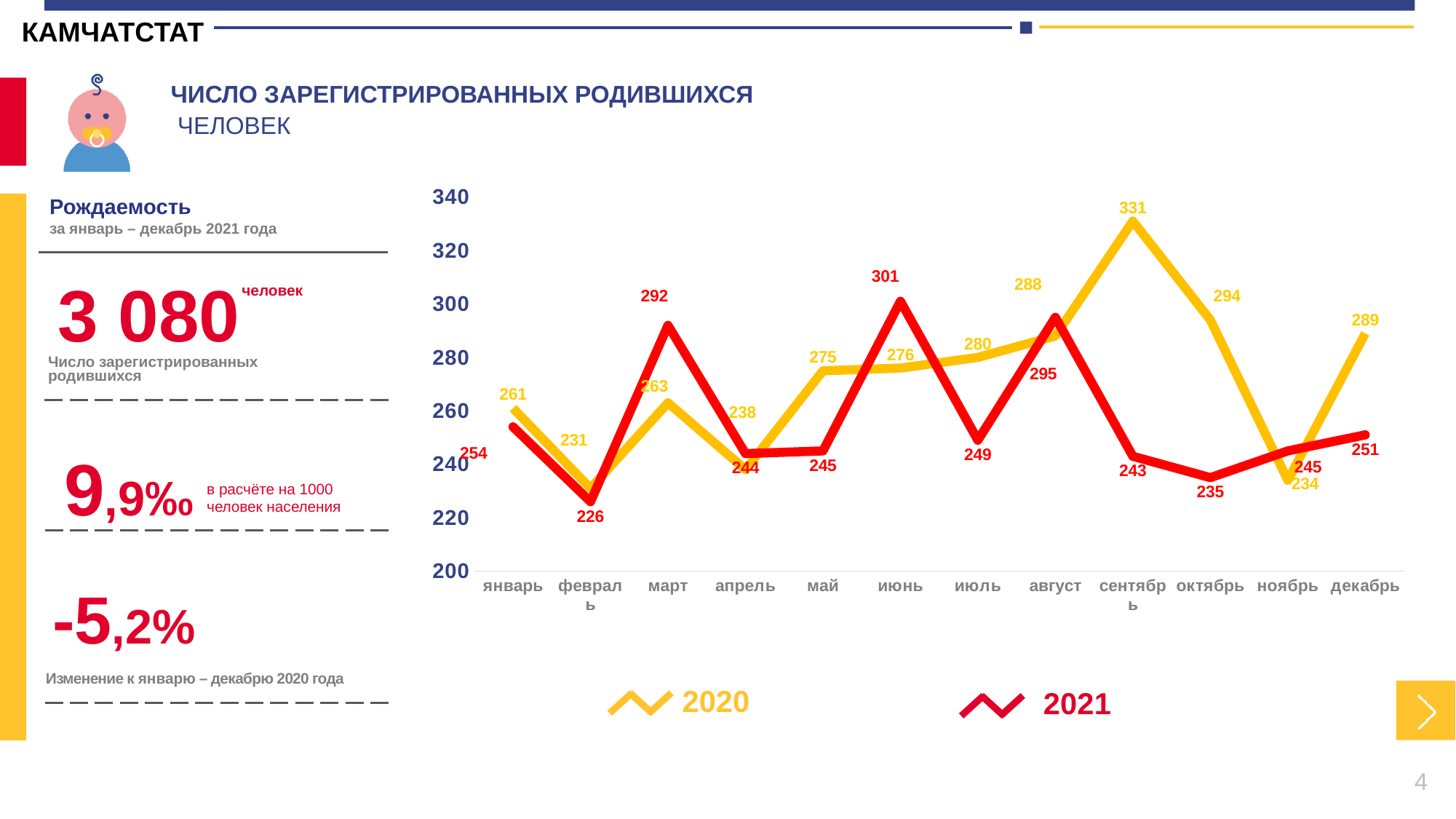
What is the value for 2020 in сентябрь? 331 What is the value for 2021 in февраль? 226 What type of chart is shown on the slide? line chart Which series has the larger value in март, 2020 or 2021? 2021 How many months are plotted along the x axis? 12 In which month is the 2021 series lowest? февраль In which month is the 2020 series highest? сентябрь What is the difference between the 2020 and 2021 values in сентябрь? 88 Is the value for 2020 in ноябрь greater or less than 240? less How many series does the legend list? 2 What is the value for 2021 in июнь? 301 Which colour represents the 2021 series in the legend? red